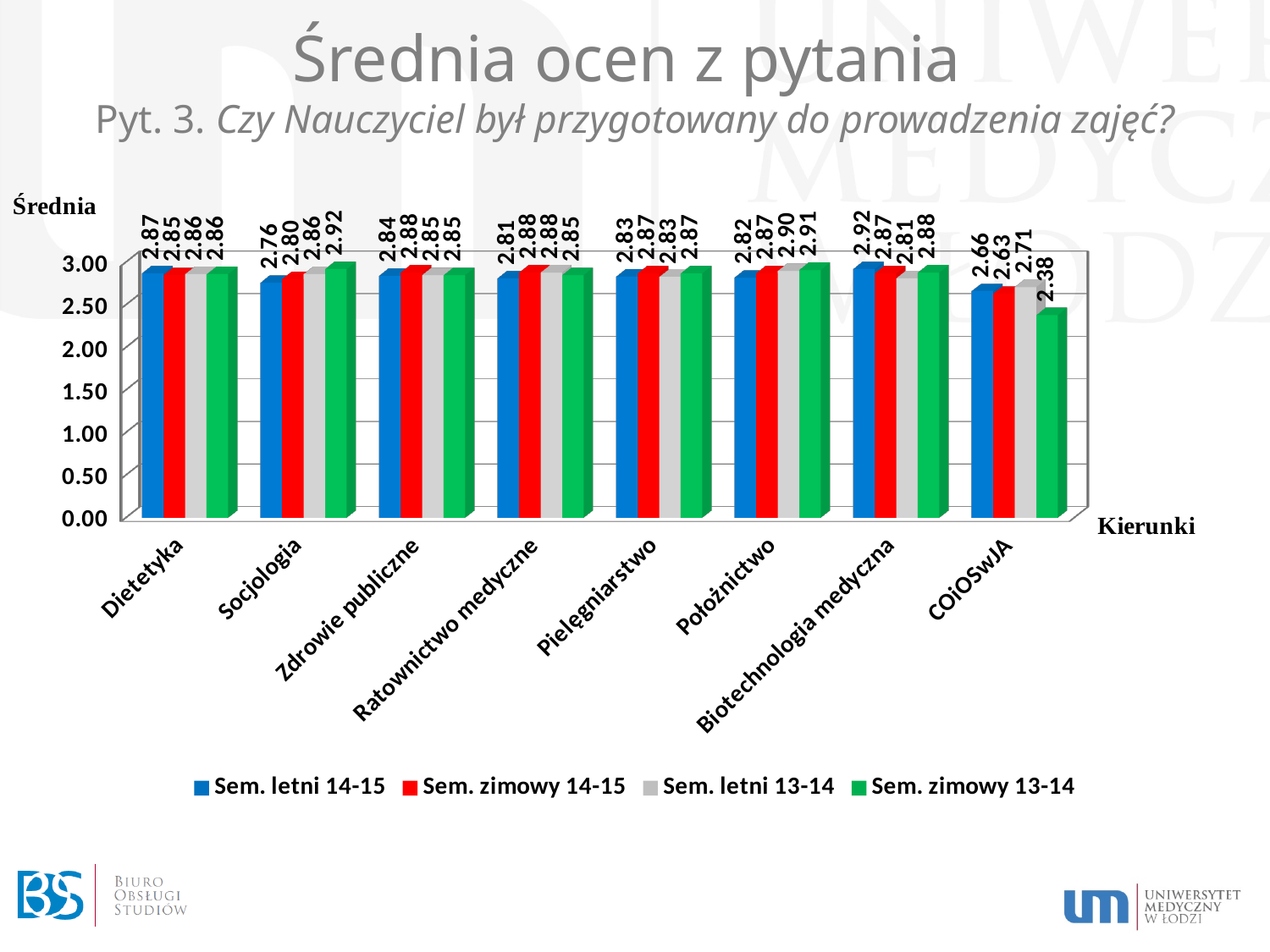
What is the difference between the Sem. zimowy 13-14 and Sem. letni 14-15 values for Socjologia? 0.16 How many series does the legend list? 4 Which category has the highest value in the Sem. letni 14-15 series? Biotechnologia medyczna For COiOSwJA, which is larger: the Sem. letni 13-14 value or the Sem. zimowy 13-14 value? Sem. letni 13-14 Which category has the lowest value in the Sem. zimowy 13-14 series? COiOSwJA What is the value for Dietetyka in the Sem. letni 14-15 series? 2.87 Is the Sem. zimowy 13-14 value for COiOSwJA greater or less than 2.50? less What is the value for Położnictwo in the Sem. letni 13-14 series? 2.90 What is the value for COiOSwJA in the Sem. zimowy 13-14 series? 2.38 Which colour represents the Sem. zimowy 14-15 series in the legend? red How many categories (kierunki) are shown on the x axis? 8 What kind of chart is shown on the slide? bar chart